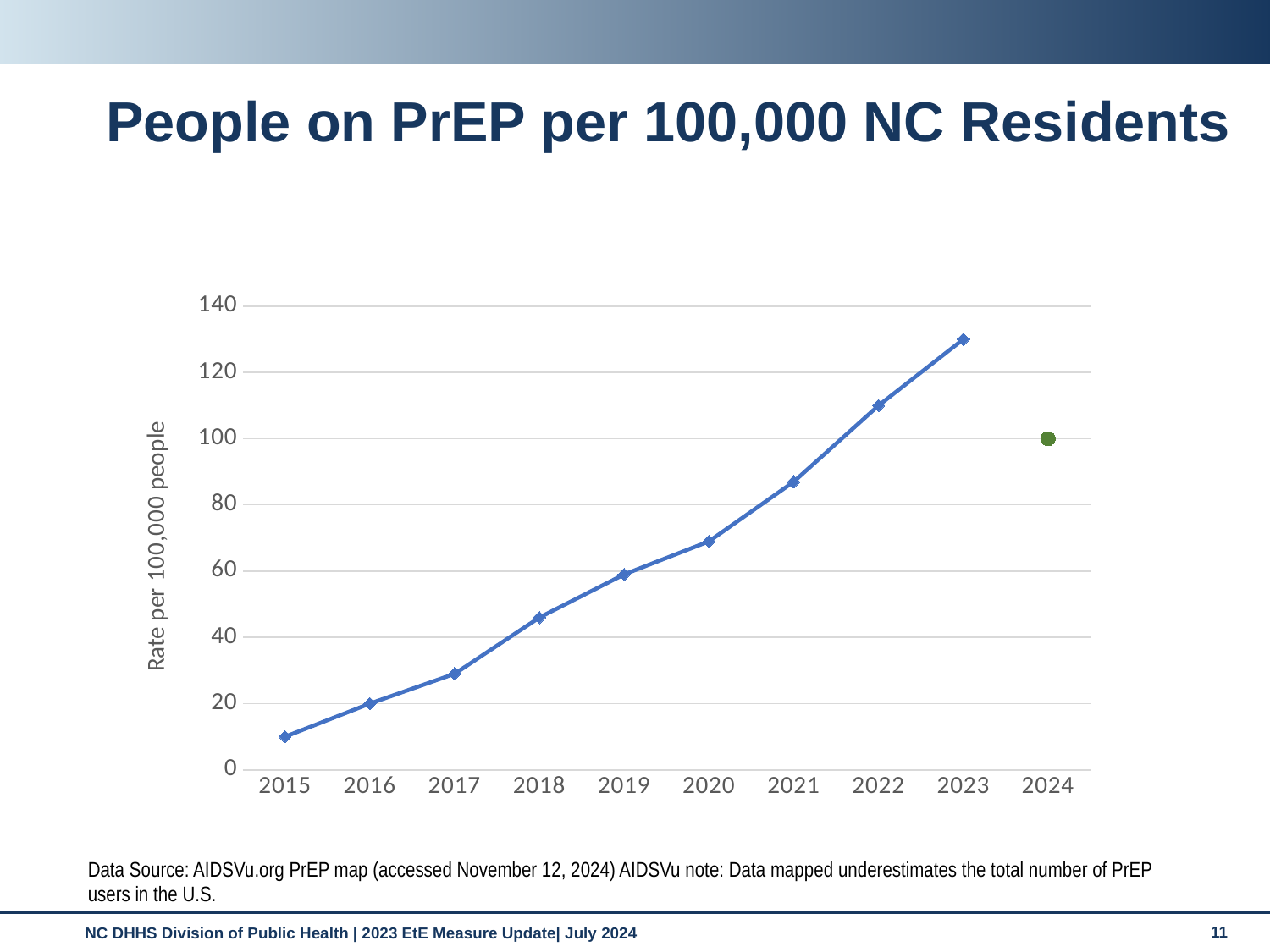
Is the value for 2023 greater or less than 120? greater How many years are shown on the x axis? 10 What is the label on the vertical axis? Rate per 100,000 people Which year has the highest plotted value? 2023 Is the value for 2017 greater or less than 40? less Do the values rise or fall from 2015 to 2023? rise Which year has the larger value, 2019 or 2021? 2021 What is the title of the chart? People on PrEP per 100,000 NC Residents Which year has the lowest plotted value? 2015 What kind of chart is shown on the slide? line chart Is the value for 2020 greater or less than 80? less